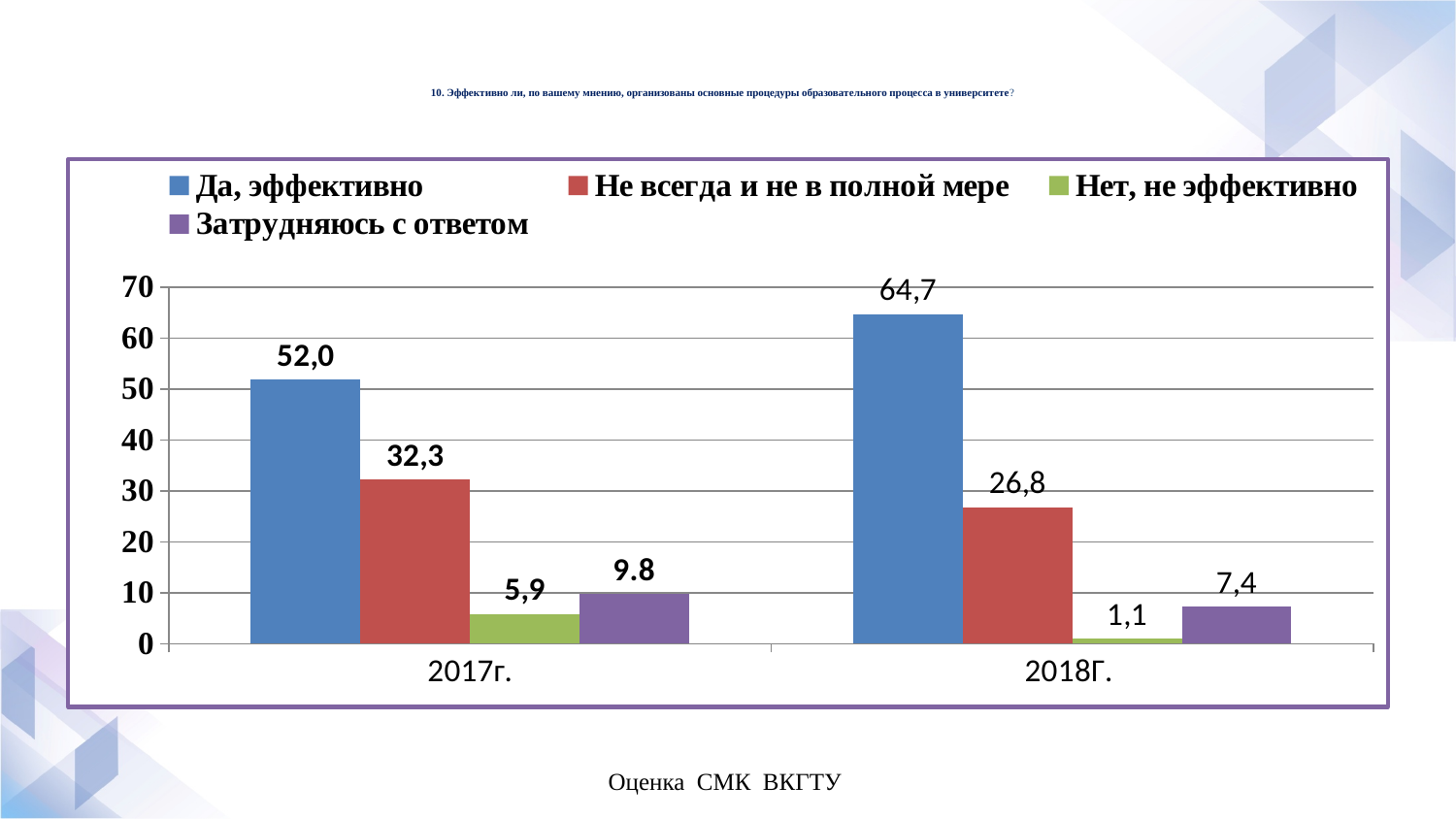
What is the difference between the "Да, эффективно" values for 2018Г. and 2017г.? 12,7 Which series has the highest value in 2018Г.? Да, эффективно What kind of chart is shown on the slide? Bar chart Is the value for "Да, эффективно" in 2018Г. greater or less than 60? greater What is the value for "Не всегда и не в полной мере" in 2018Г.? 26,8 What colour represents "Нет, не эффективно" in the legend? Green Which is larger: "Не всегда и не в полной мере" in 2017г. or in 2018Г.? 2017г. What is the value for "Да, эффективно" in 2017г.? 52,0 Which series has the lowest value in 2017г.? Нет, не эффективно What is the value for "Затрудняюсь с ответом" in 2017г.? 9.8 How many series does the legend list? 4 What is the value for "Нет, не эффективно" in 2018Г.? 1,1